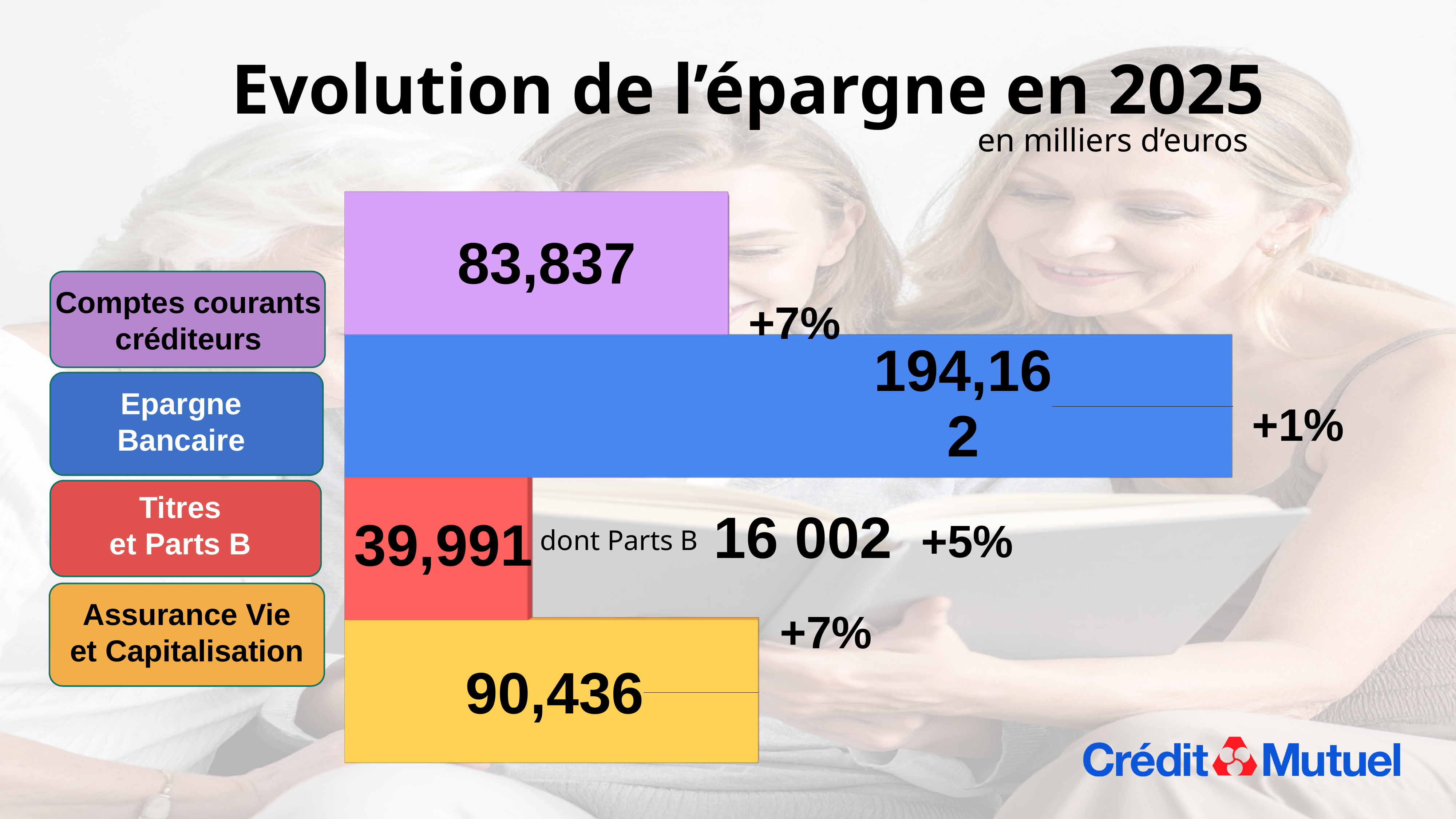
What is the value for Titres et Parts B? 39,991 What is the value for Assurance Vie et Capitalisation? 90,436 Which category has the lowest value? Titres et Parts B How many categories are shown in the chart? 4 What is the value for Epargne Bancaire? 194,162 What is the value for Comptes courants créditeurs? 83,837 What is the Parts B amount shown within Titres et Parts B? 16 002 Which is larger, the value for Assurance Vie et Capitalisation or the value for Comptes courants créditeurs? Assurance Vie et Capitalisation Which category has the highest value? Epargne Bancaire What percentage change is shown for Titres et Parts B? +5% What is the difference between the values for Assurance Vie et Capitalisation and Comptes courants créditeurs? 6,599 What percentage change is shown for Epargne Bancaire? +1%